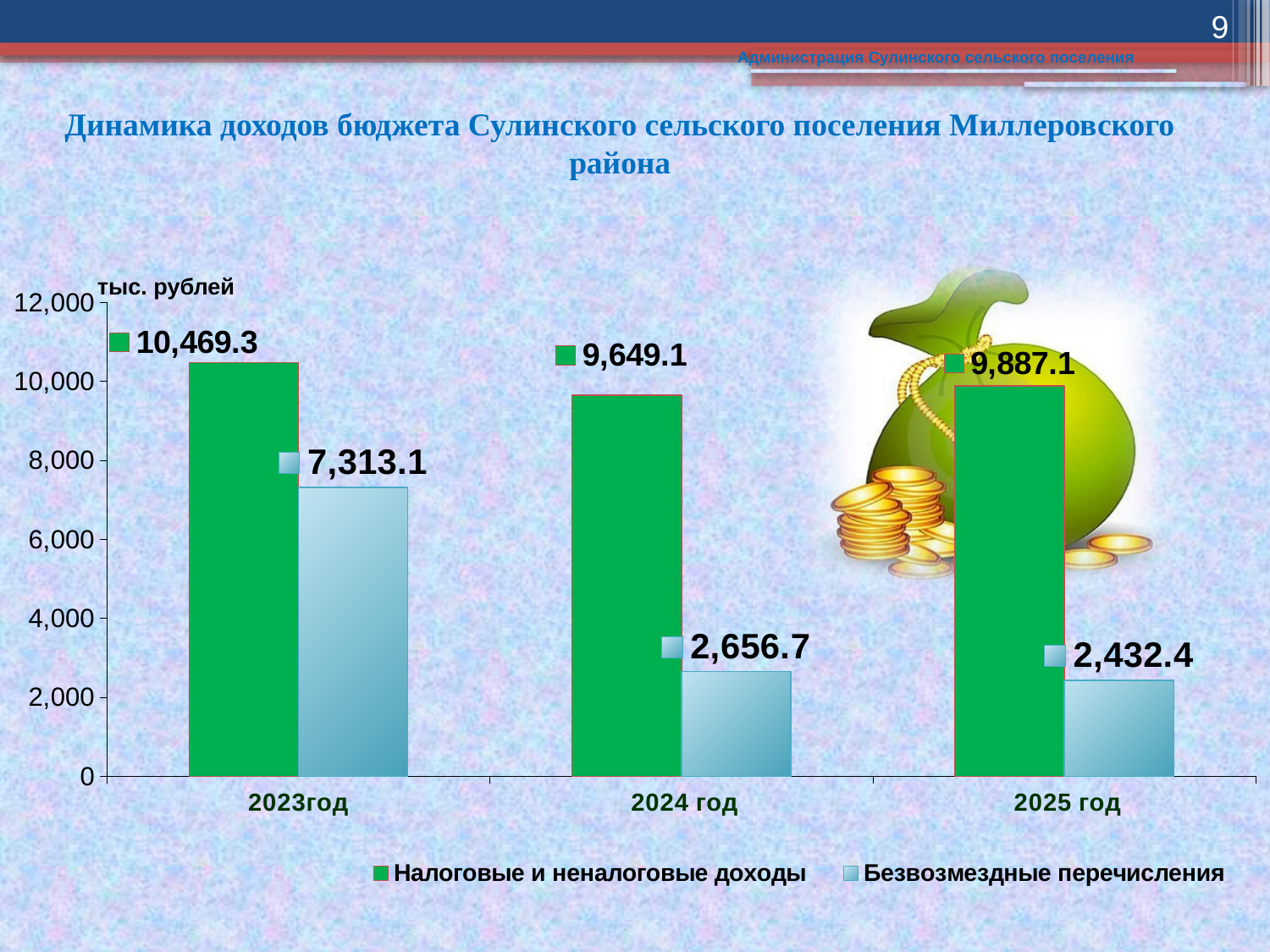
How many series does the legend list? 2 In which year is Налоговые и неналоговые доходы the highest? 2023год Do the values for Безвозмездные перечисления rise or fall from 2023год to 2025 год? Fall What kind of chart is shown on the slide? Bar chart What is the value of Налоговые и неналоговые доходы for 2023год? 10,469.3 Which is larger: Налоговые и неналоговые доходы in 2024 год or in 2025 год? 2025 год What is the value of Безвозмездные перечисления for 2024 год? 2,656.7 How many years are shown on the x axis? 3 In which year is Безвозмездные перечисления the lowest? 2025 год What is the difference between Налоговые и неналоговые доходы and Безвозмездные перечисления in 2023год? 3,156.2 By how much did Безвозмездные перечисления fall from 2023год to 2024 год? 4,656.4 What is the value of Безвозмездные перечисления for 2025 год? 2,432.4